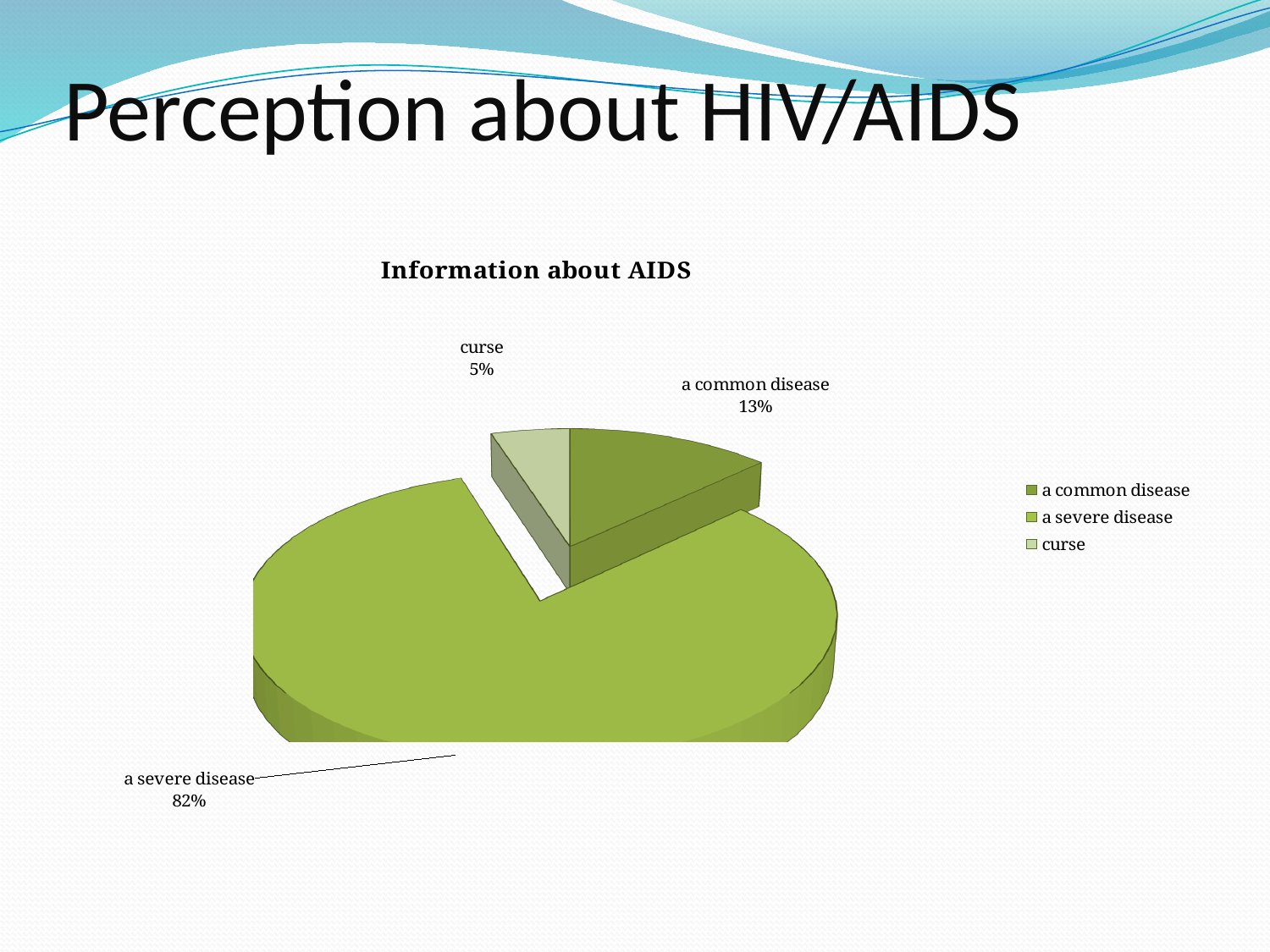
What is the difference in percentage points between 'a severe disease' and 'a common disease'? 69 How many entries does the legend list? 3 What is the title of the chart? Information about AIDS What kind of chart is shown on the slide? pie chart How many categories are shown in the pie chart? 3 What share of the pie is labelled 'a severe disease'? 82% Which category has the largest slice of the pie? a severe disease What share of the pie is labelled 'curse'? 5% Which is larger, the share for 'a common disease' or the share for 'curse'? a common disease Which category has the smallest slice of the pie? curse What is the difference in percentage points between 'a common disease' and 'curse'? 8 What share of the pie is labelled 'a common disease'? 13%